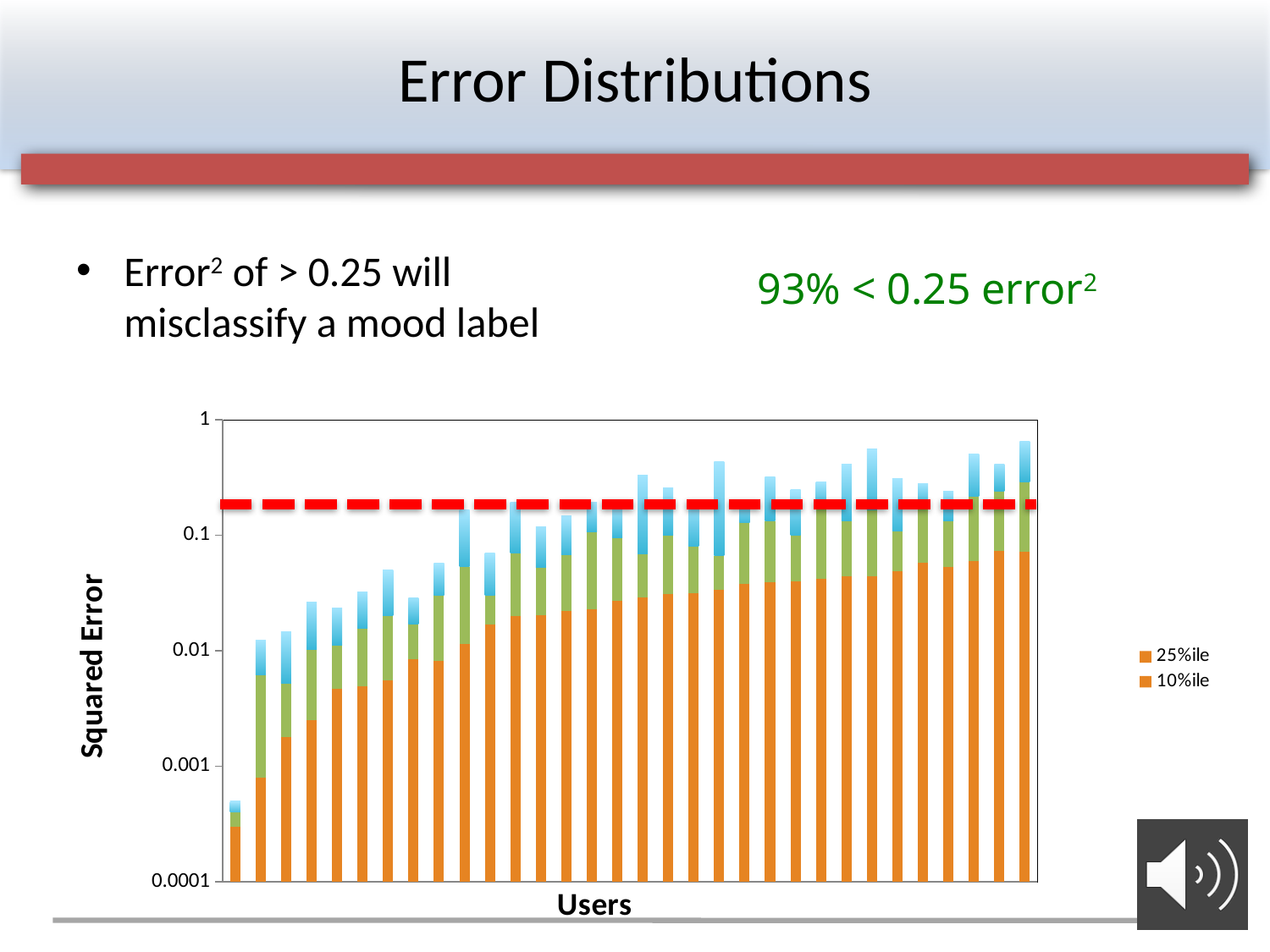
What is the title of the vertical axis of the chart? Squared Error Is the total height of the leftmost bar greater or less than 0.001? less What is the highest value shown on the vertical axis of the chart? 1 Do the bar heights generally rise or fall moving from left to right along the Users axis? Rise What is the lowest value shown on the vertical axis of the chart? 0.0001 Which bar has the lowest squared error in the chart? The leftmost bar What kind of chart is shown on the slide? Stacked bar chart How many series does the chart legend list? 2 Is the total height of the rightmost bar greater or less than 0.1? greater Which is taller, the leftmost bar or the rightmost bar? The rightmost bar What are the two entries in the chart legend? 25%ile and 10%ile